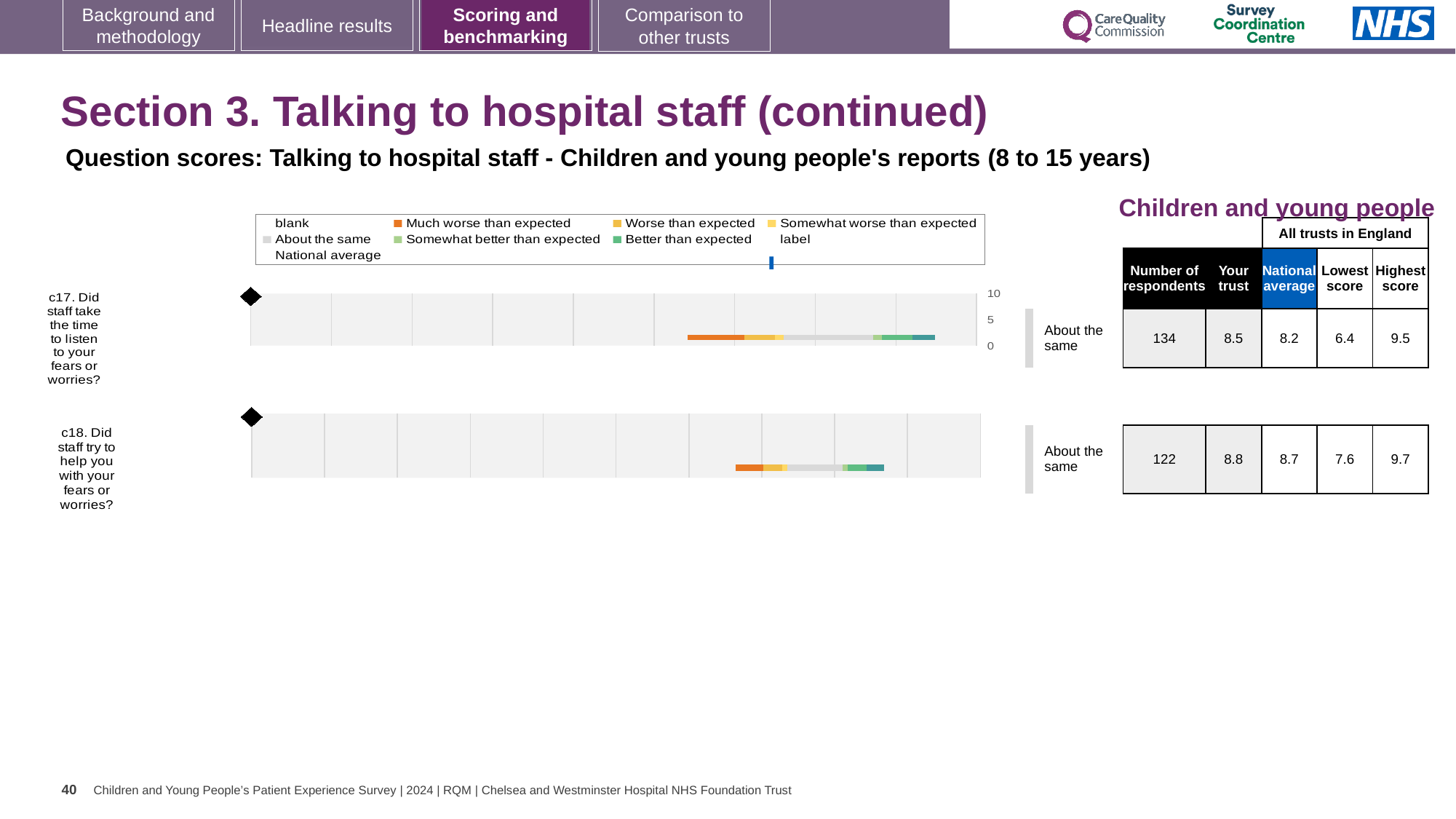
What is the trust's score for c17 (Did staff take the time to listen to your fears or worries?)? 8.5 What is the difference between the trust's score and the national average for c18? 0.1 Which question has the higher 'Highest score' across all trusts in England? c18 Which question has the higher trust score, c17 or c18? c18 How many respondents answered question c17? 134 What is the lowest score across all trusts in England for c18? 7.6 What kind of chart is used to show the question scores for c17 and c18? bar chart What colour does the legend use for 'Much worse than expected'? orange How many survey questions are plotted on the slide? 2 What is the difference between the highest and lowest scores across all trusts in England for c17? 3.1 What is the national average score for c18 (Did staff try to help you with your fears or worries?)? 8.7 What benchmark category is shown for c17? About the same